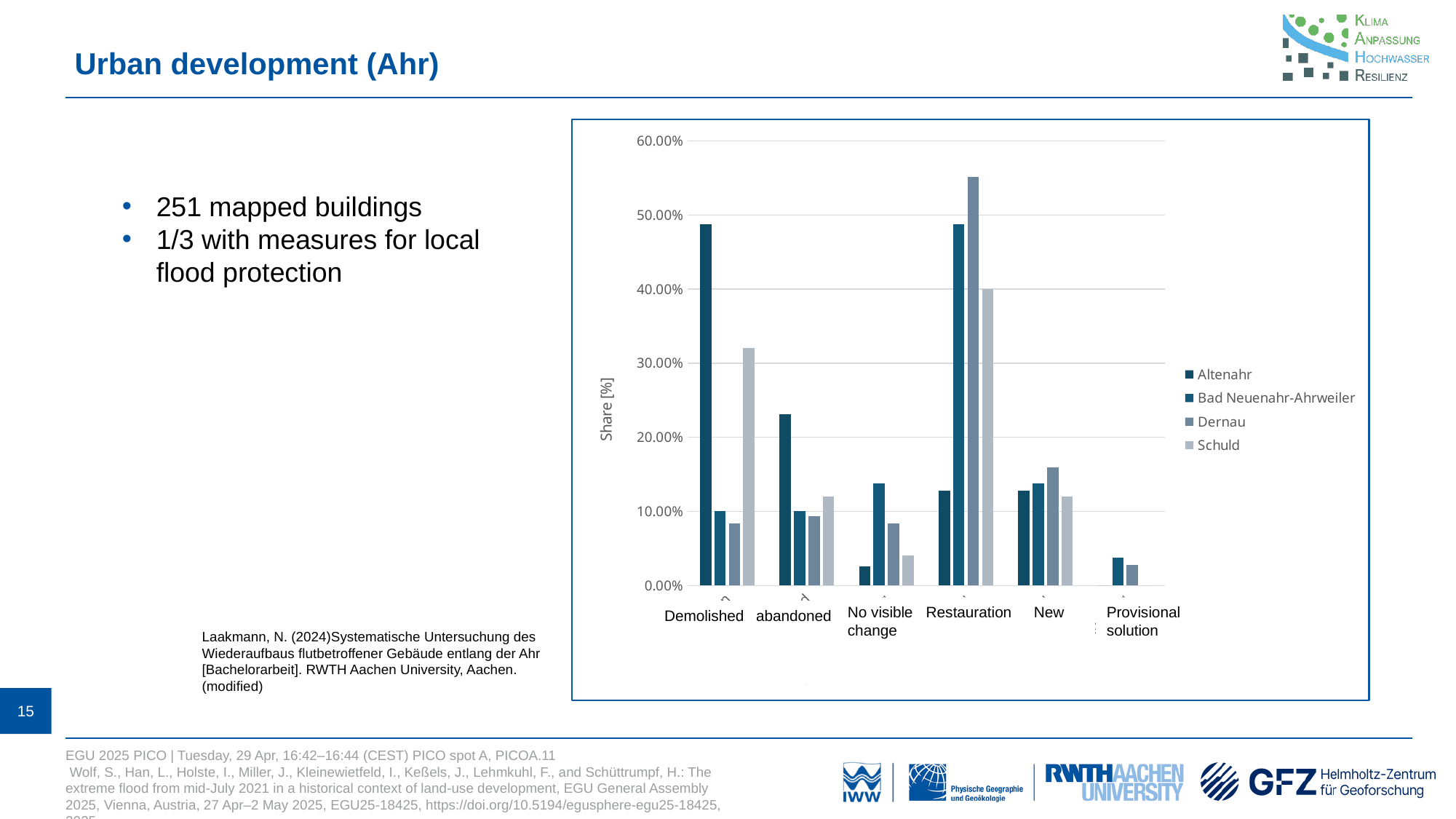
Is the value for Altenahr in the No visible change category greater or less than 10.00%? less In the abandoned category, which is larger: the value for Altenahr or the value for Schuld? Altenahr Is the value for Dernau in the Restauration category greater or less than 50.00%? greater What is the label of the y axis of the chart? Share [%] What kind of chart is shown on the slide? bar chart Which series has the highest value in the Demolished category? Altenahr Which series has the highest value in the Restauration category? Dernau Which series has the lowest value in the No visible change category? Altenahr Is the value for Schuld in the Demolished category greater or less than 30.00%? greater How many series does the chart's legend list? 4 Which series is listed last in the chart's legend? Schuld How many categories are shown along the x axis of the chart? 6